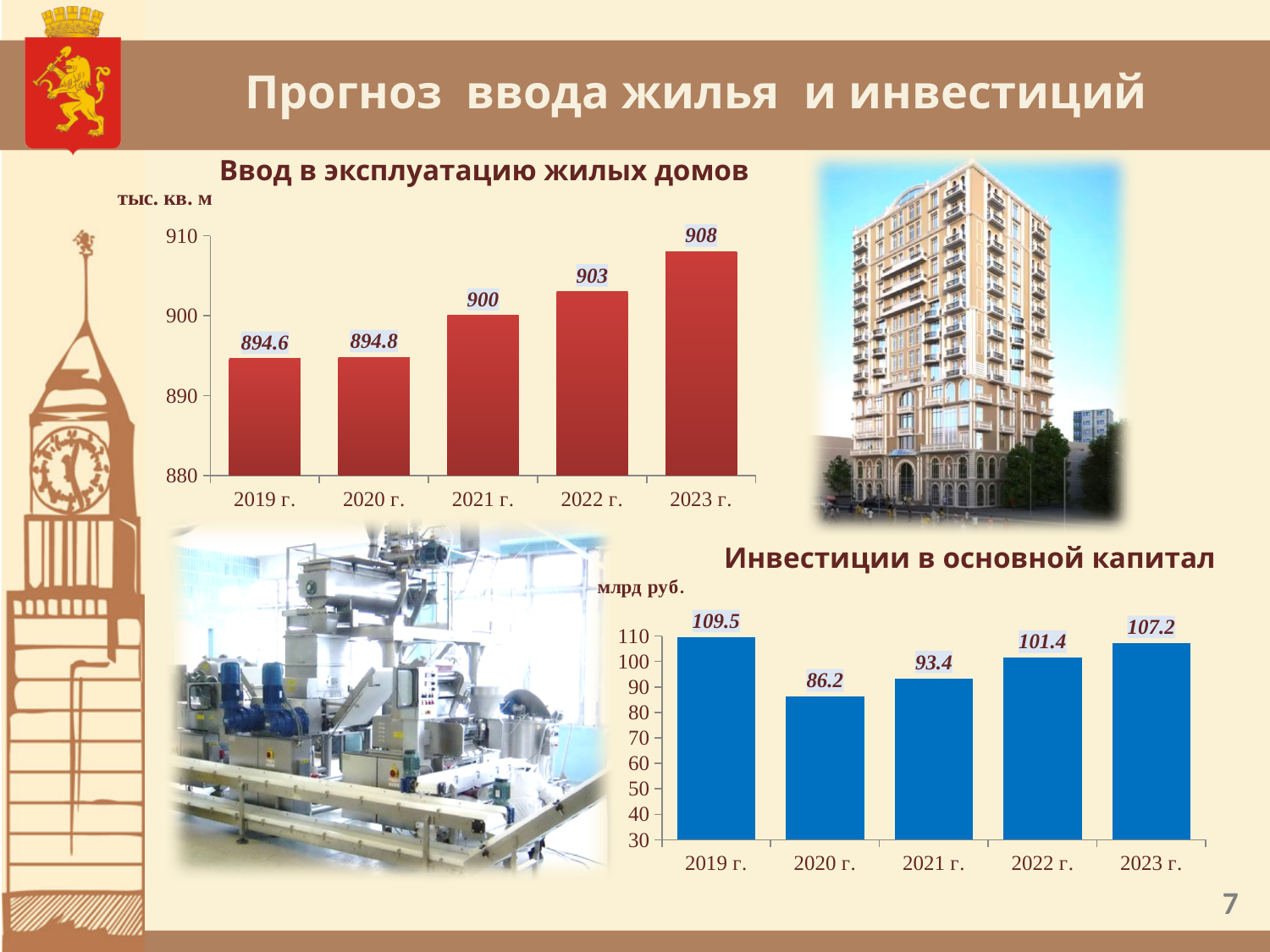
In the chart 'Ввод в эксплуатацию жилых домов', what is the value for 2021 г.? 900 In the chart 'Ввод в эксплуатацию жилых домов', do the values rise or fall from 2019 г. to 2023 г.? rise In the chart 'Инвестиции в основной капитал', which is larger, the value for 2019 г. or 2023 г.? 2019 г. What kind of chart is 'Инвестиции в основной капитал'? bar chart In the chart 'Ввод в эксплуатацию жилых домов', what is the value for 2019 г.? 894.6 In the chart 'Инвестиции в основной капитал', what is the value for 2020 г.? 86.2 In the chart 'Ввод в эксплуатацию жилых домов', which year has the highest value? 2023 г. In the chart 'Ввод в эксплуатацию жилых домов', what is the difference between the values for 2023 г. and 2022 г.? 5 In the chart 'Ввод в эксплуатацию жилых домов', how many years are shown on the x axis? 5 In the chart 'Инвестиции в основной капитал', what is the value for 2022 г.? 101.4 In the chart 'Инвестиции в основной капитал', what is the difference between the values for 2019 г. and 2020 г.? 23.3 In the chart 'Инвестиции в основной капитал', which year has the lowest value? 2020 г.